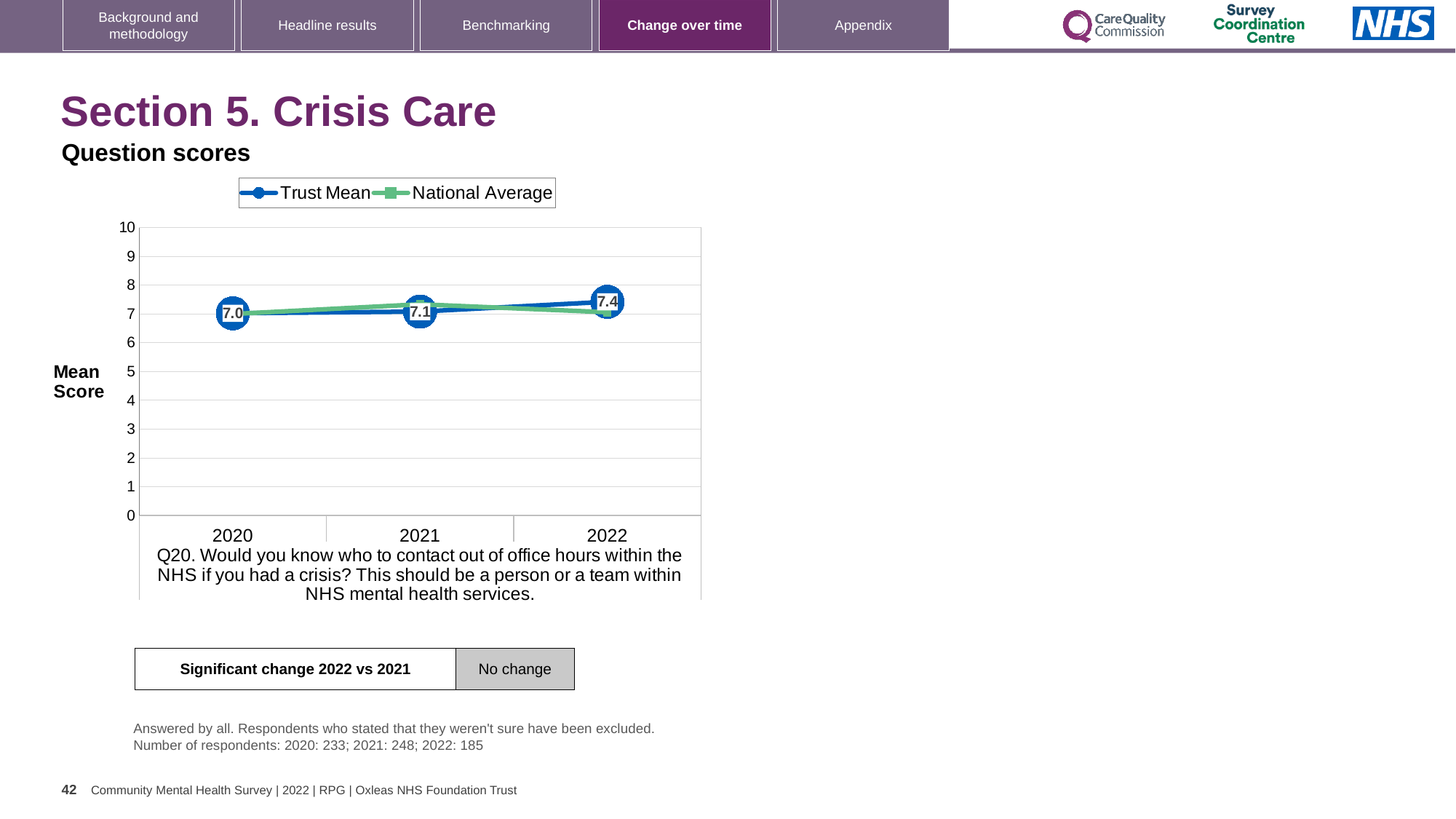
How many years are plotted on the x axis? 3 What is the Trust Mean score for 2021? 7.1 How many series does the legend list? 2 What is the Trust Mean score for 2020? 7.0 In which year is the Trust Mean score highest? 2022 Which is larger, the Trust Mean score for 2022 or for 2021? 2022 What kind of chart is shown on the slide? line chart Is the National Average value for 2022 greater or less than 5? greater Does the Trust Mean score rise or fall from 2020 to 2022? rise What is the difference between the Trust Mean score in 2022 and in 2020? 0.4 In which year is the Trust Mean score lowest? 2020 What is the Trust Mean score for 2022? 7.4